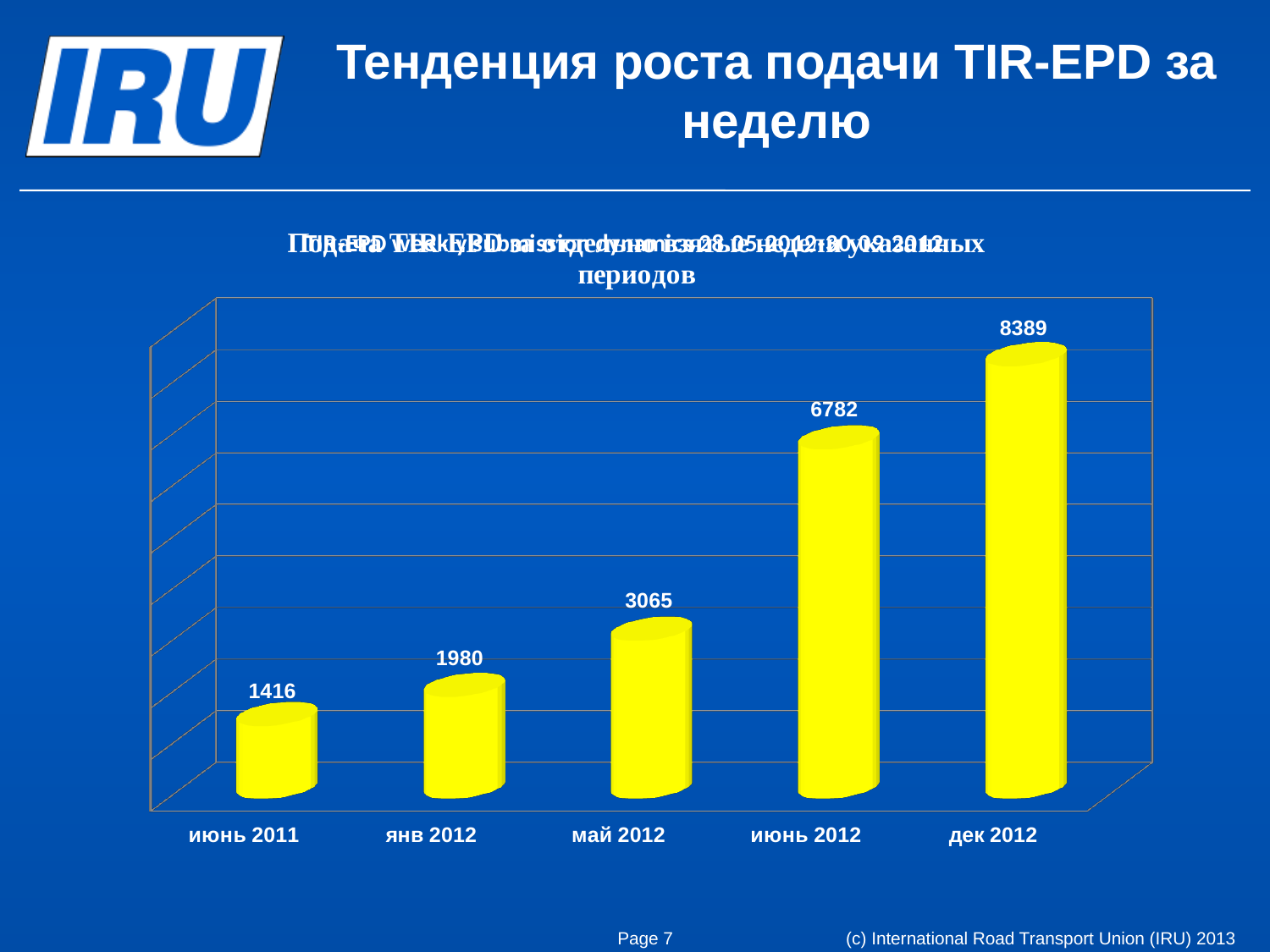
Which category has the highest value? дек 2012 Which is larger, the value for июнь 2012 or the value for май 2012? июнь 2012 What kind of chart is shown on the slide? bar chart What is the value for июнь 2011? 1416 What is the value for дек 2012? 8389 How many categories are shown on the x axis? 5 What is the difference between the values for май 2012 and янв 2012? 1085 What is the value for июнь 2012? 6782 What is the difference between the values for дек 2012 and июнь 2012? 1607 What is the value for янв 2012? 1980 Which category has the lowest value? июнь 2011 What is the value for май 2012? 3065